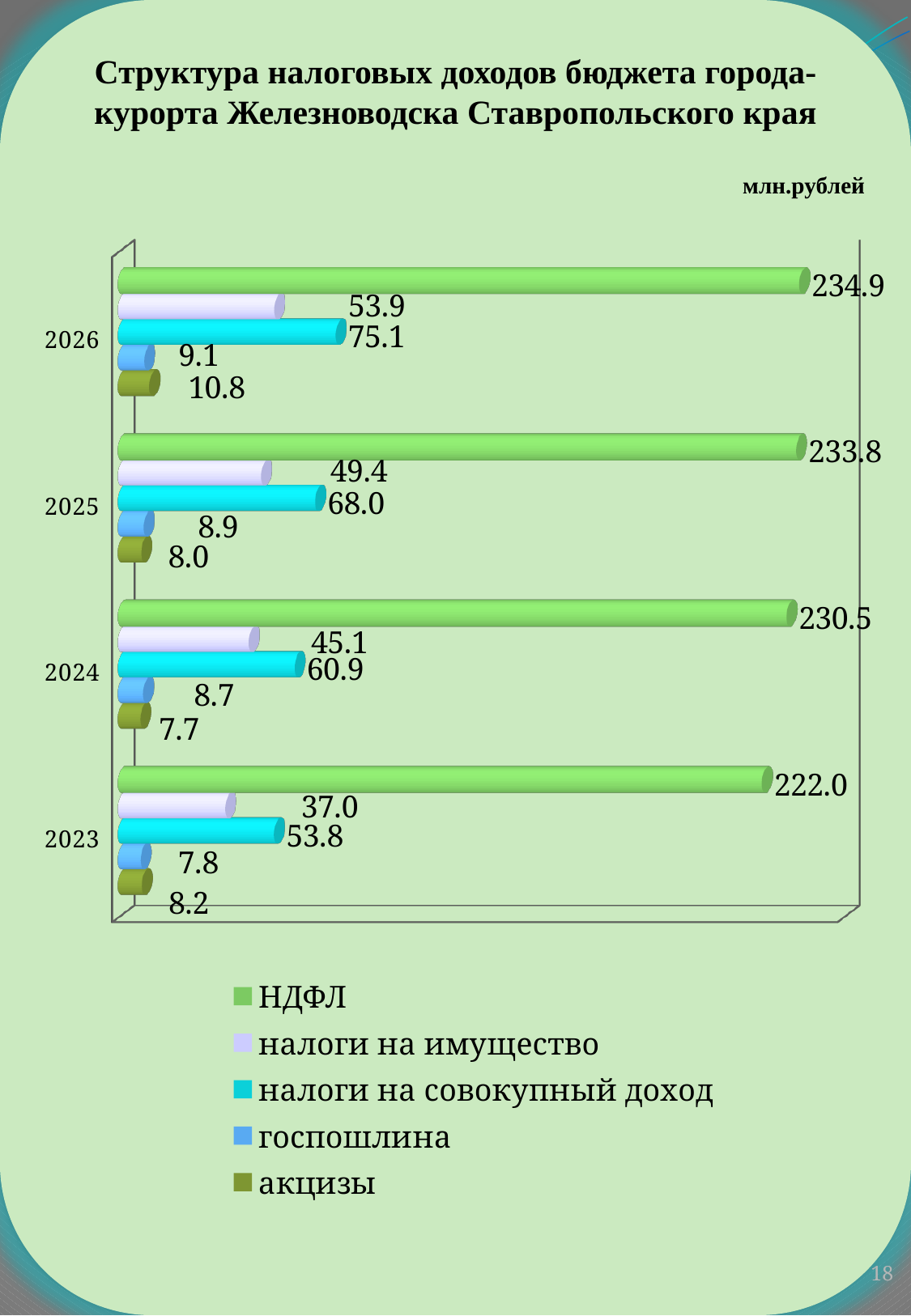
In which year is the value for налоги на имущество the highest? 2026 What unit of measurement is indicated on the slide for the chart values? млн.рублей How many series does the legend list? 5 What is the value for госпошлина in 2025? 8.9 What is the value for налоги на совокупный доход in 2024? 60.9 What kind of chart is shown on the slide? bar chart How many years are shown on the chart? 4 In which year is the value for НДФЛ the lowest? 2023 Which is larger in 2025: налоги на имущество or налоги на совокупный доход? налоги на совокупный доход What is the value for акцизы in 2023? 8.2 What is the difference between the НДФЛ values for 2026 and 2023? 12.9 What is the value for НДФЛ in 2026? 234.9